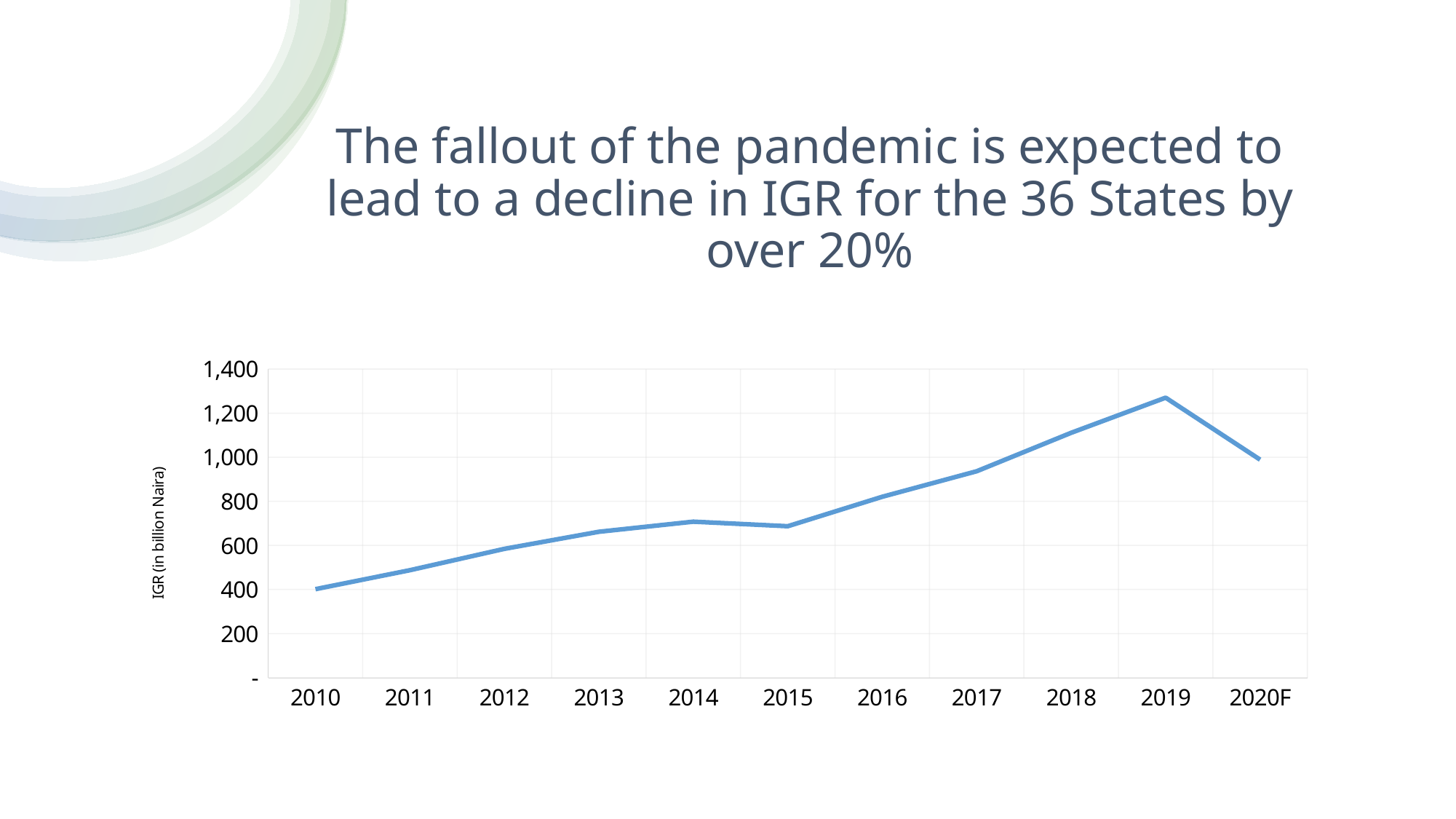
Does the IGR value rise or fall from 2019 to 2020F? fall Is the IGR value for 2019 greater or less than 1,200? greater Which year has the lowest IGR value? 2010 Is the IGR value for 2020F greater or less than 800? greater What is the label on the y axis of the chart? IGR (in billion Naira) Is the IGR value for 2016 greater or less than 1,000? less Which year has the larger IGR value, 2019 or 2020F? 2019 What kind of chart is shown on the slide? line chart Which year has the highest IGR value? 2019 How many years are plotted along the x axis? 11